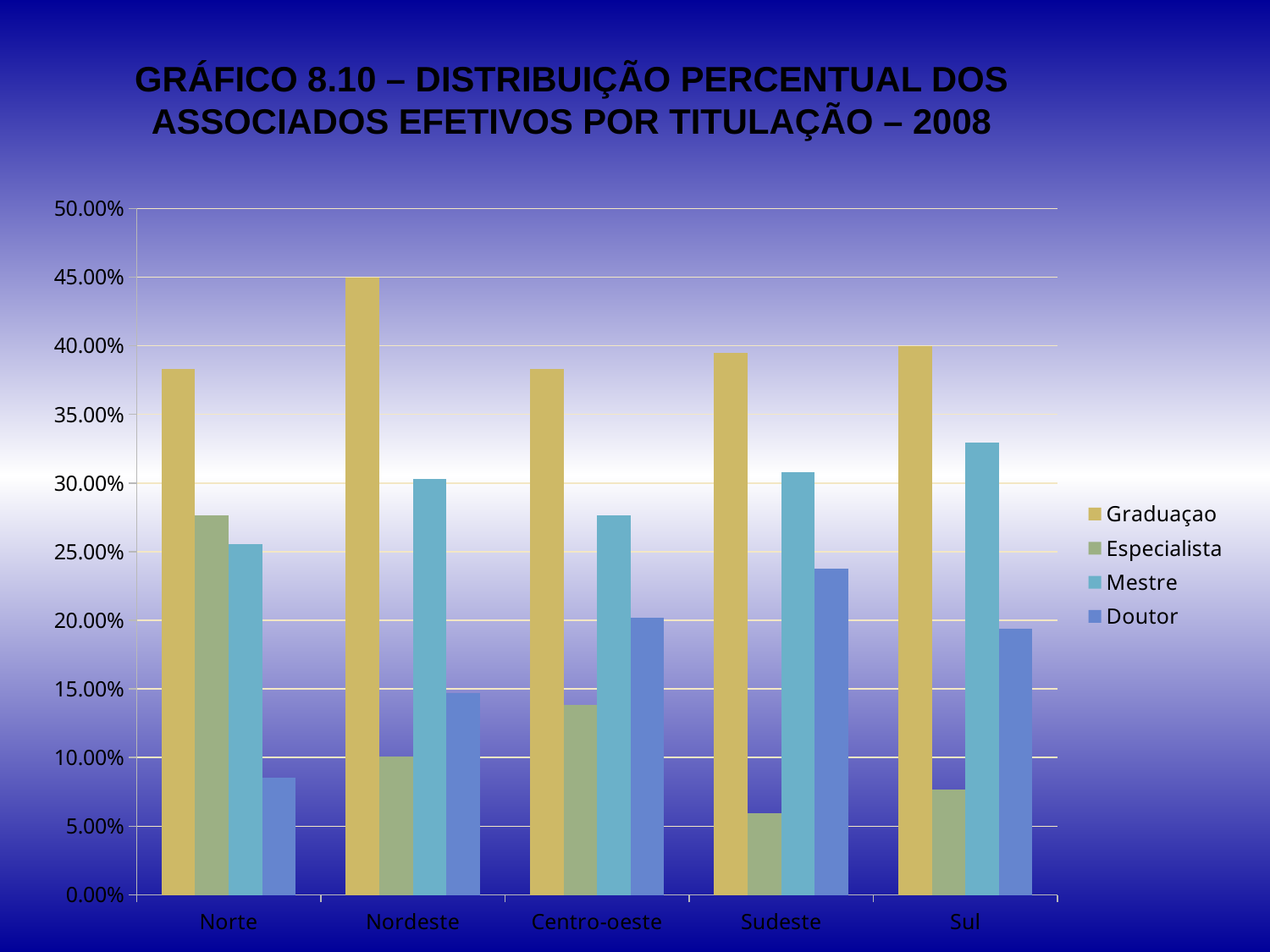
Is the Graduaçao value for Nordeste greater or less than 40.00%? greater What kind of chart is shown on the slide? bar chart How many series does the legend list? 4 In which region is the Doutor value highest? Sudeste Which series is shown in yellow in the legend? Graduaçao Which is larger for Norte: the Especialista value or the Doutor value? Especialista Is the Mestre value for Sul greater or less than 30.00%? greater Is the Especialista value for Sudeste greater or less than 10.00%? less How many regions are shown on the x axis? 5 In which region is the Especialista value lowest? Sudeste In which region is the Graduaçao value highest? Nordeste